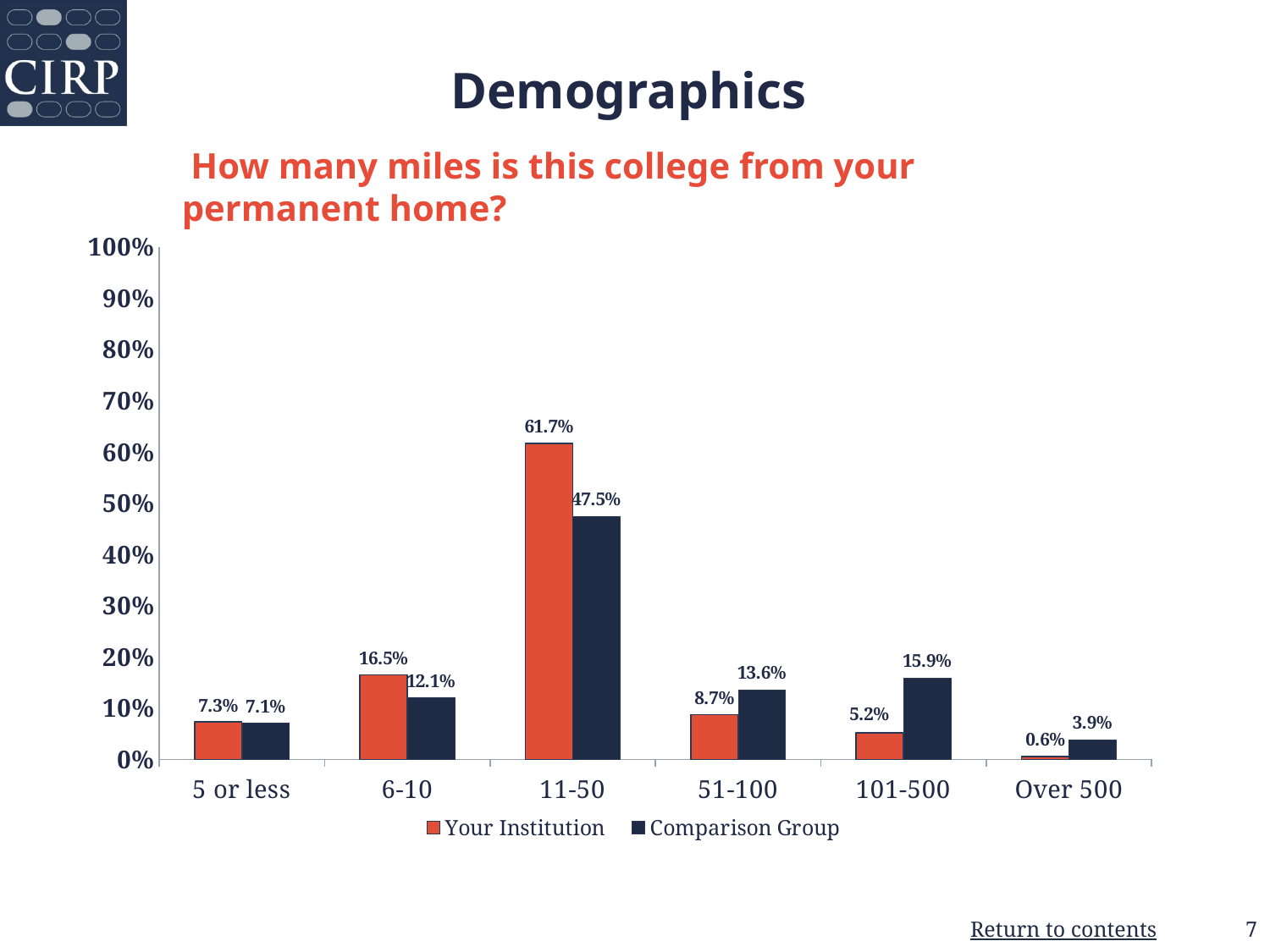
What kind of chart is shown on the slide? bar chart What is the value for Comparison Group in the 101-500 category? 15.9% What question does the chart title ask? How many miles is this college from your permanent home? Is the value for Your Institution in the 6-10 category greater or less than 10%? greater What is the value for Your Institution in the Over 500 category? 0.6% Which category has the lowest value for Your Institution? Over 500 Which is larger in the 51-100 category, Your Institution or Comparison Group? Comparison Group What is the value for Your Institution in the 11-50 category? 61.7% Which category has the highest value for Comparison Group? 11-50 How many categories are shown on the x axis? 6 What is the difference between Your Institution and Comparison Group in the 11-50 category? 14.2% How many series does the legend list? 2